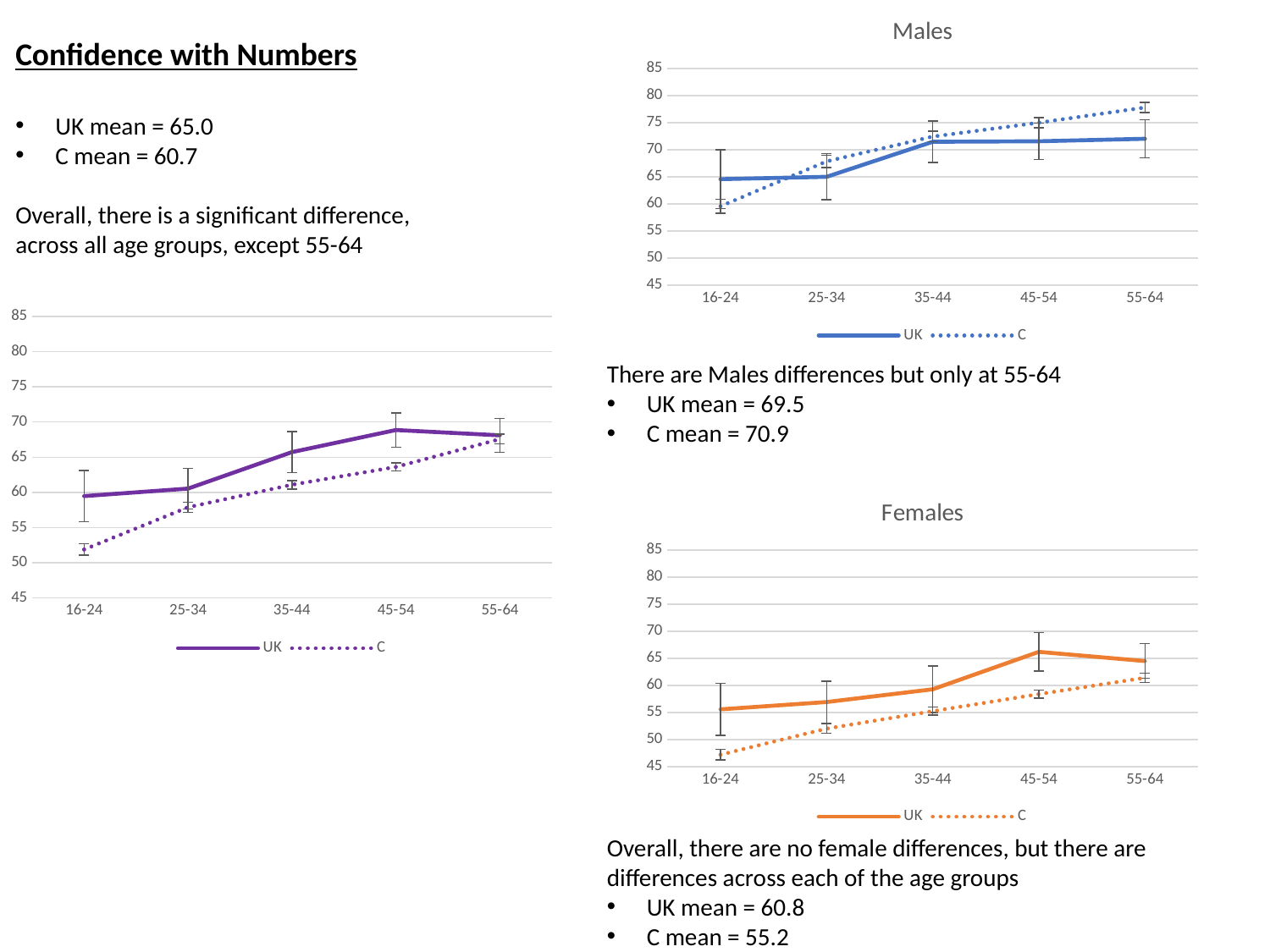
How many series does the legend of the Males chart list? 2 In the Females chart, which series has the larger value at 45-54, UK or C? UK In the Females chart, which age group has the lowest value for the C series? 16-24 In the Males chart, which series has the larger value at 16-24, UK or C? UK In the Males chart, is the value for UK at 16-24 greater or less than 70? less In the Females chart, which series is drawn with a dotted line? C In the chart on the left of the slide, does the C series rise or fall from 16-24 to 55-64? rise How many age groups are shown on the x axis of the Females chart? 5 In the Females chart, is the value for C at 16-24 greater or less than 50? less What type of chart is the Males chart? line chart In the Males chart, which age group has the highest value for the C series? 55-64 In the Males chart, is the value for C at 55-64 greater or less than 75? greater